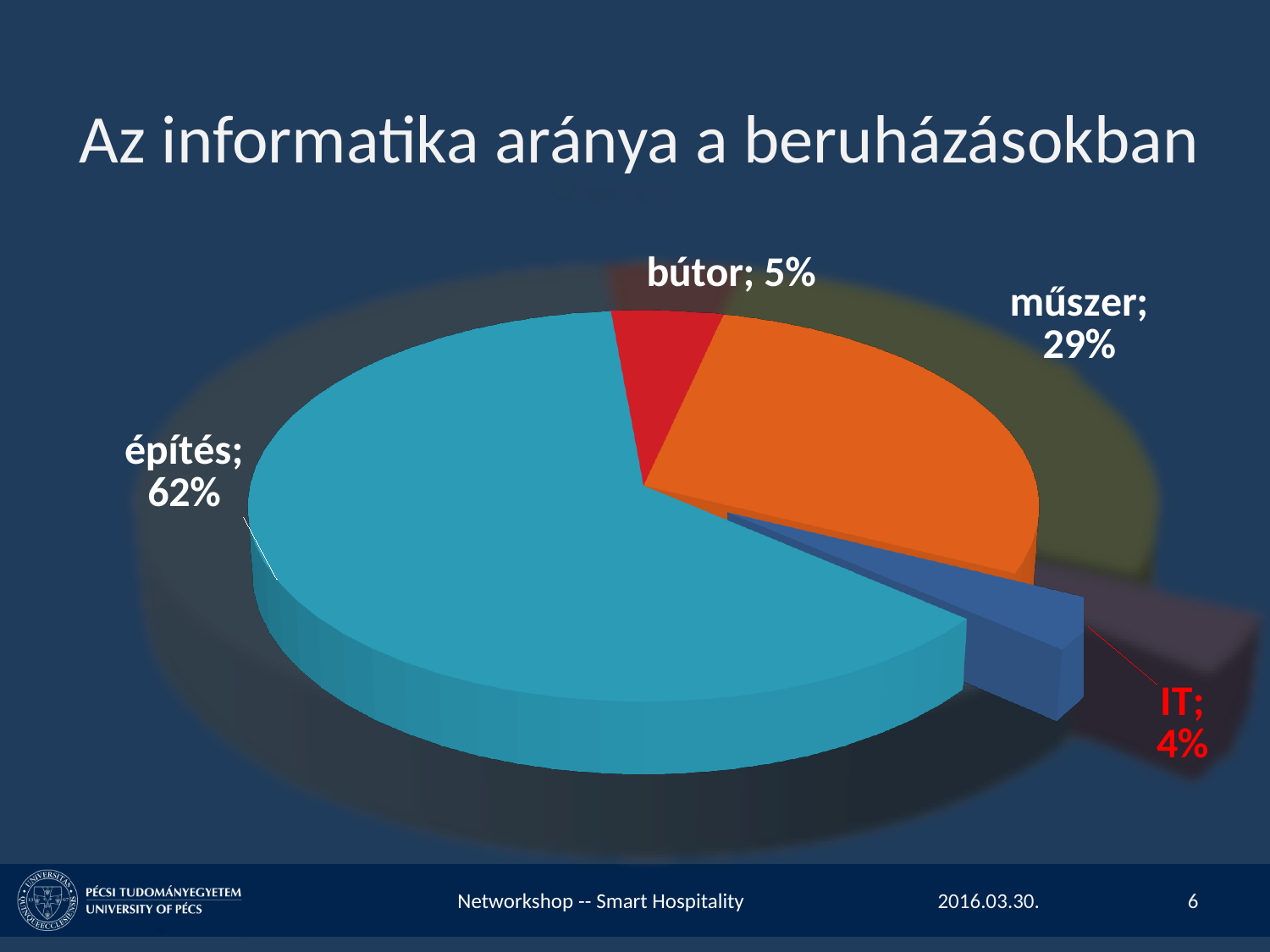
What share of the pie does építés have? 62% What is the difference between the shares of bútor and IT? 1% How many categories are shown in the pie chart? 4 What kind of chart is shown on the slide? pie chart Which category has the largest share of the pie? építés What share of the pie does bútor have? 5% What is the title of the slide containing the chart? Az informatika aránya a beruházásokban What share of the pie does IT have? 4% Which category has the smallest share of the pie? IT Which has a larger share, műszer or bútor? műszer What share of the pie does műszer have? 29% What is the difference between the shares of építés and műszer? 33%